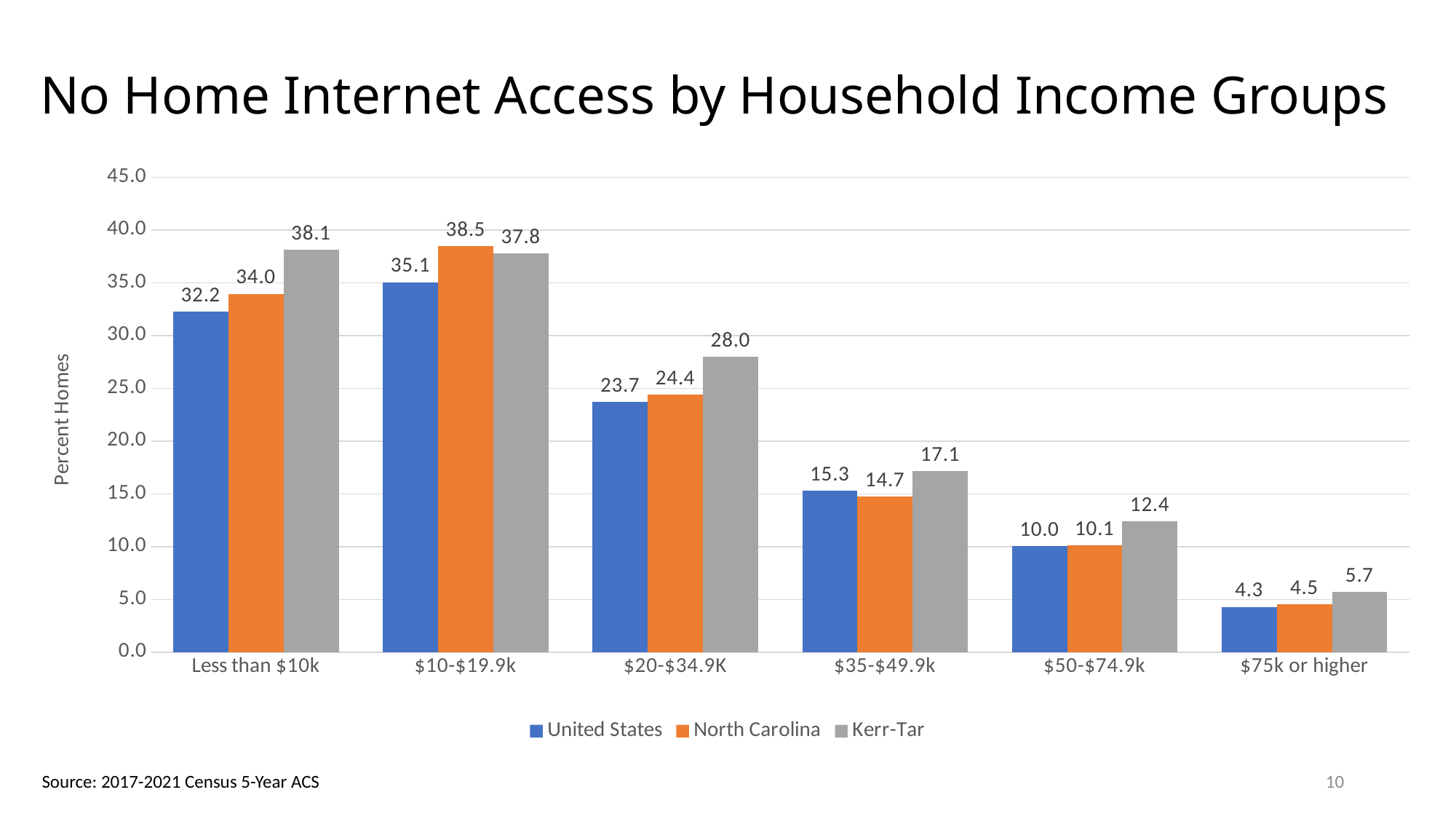
Which income group has the lowest value for the Kerr-Tar series? $75k or higher Which income group has the highest value for the North Carolina series? $10-$19.9k What is the value for North Carolina in the $75k or higher income group? 4.5 What is the label of the y axis? Percent Homes In the $10-$19.9k income group, which is larger: the North Carolina value or the Kerr-Tar value? North Carolina What kind of chart is shown on the slide? Bar chart How many series does the legend list? 3 From the $10-$19.9k group to the $75k or higher group, do the Kerr-Tar values rise or fall? Fall What is the value for United States in the Less than $10k income group? 32.2 How many income groups are shown on the x axis? 6 What is the value for Kerr-Tar in the $20-$34.9K income group? 28.0 What is the difference between the Kerr-Tar and United States values in the $35-$49.9k income group? 1.8